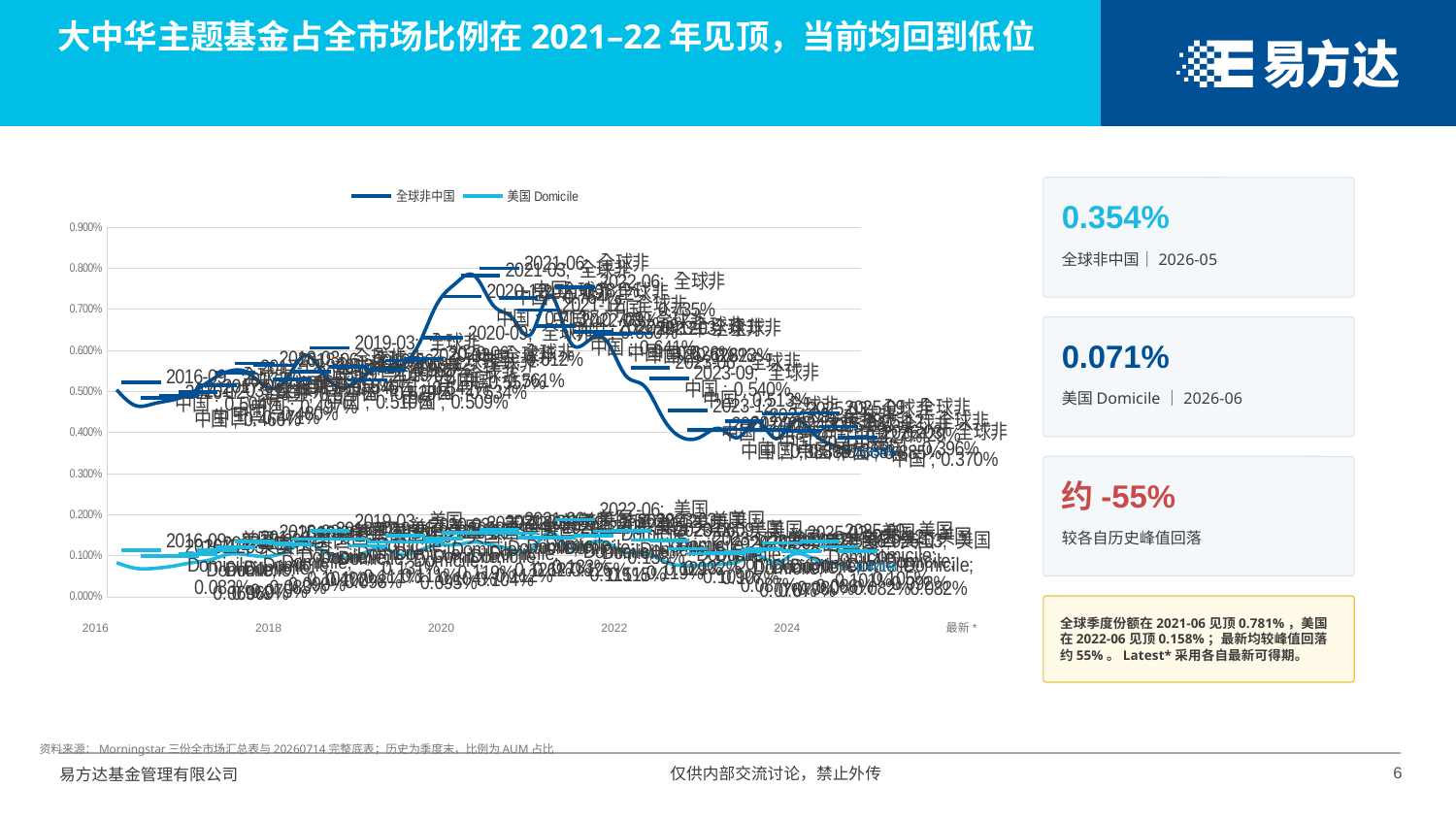
What is the highest tick value shown on the vertical axis? 0.900% What is the latest value shown for 美国 Domicile (2026-06)? 0.071% What is the latest value shown for 全球非中国 (2026-05)? 0.354% How many series does the chart legend list? 2 Is the value for 美国 Domicile at the start of 2016 greater or less than 0.200%? less What peak value did the 美国 series reach in 2022-06? 0.158% What kind of chart is shown on the slide? line chart What are the two series named in the chart legend? 全球非中国 and 美国 Domicile Does the 全球非中国 series rise or fall from its 2021 peak to the latest point? fall Is the value for 全球非中国 at the start of 2016 greater or less than 0.400%? greater Which series is plotted higher throughout the chart, 全球非中国 or 美国 Domicile? 全球非中国 What peak value did the 全球非中国 series reach in 2021-06? 0.781%